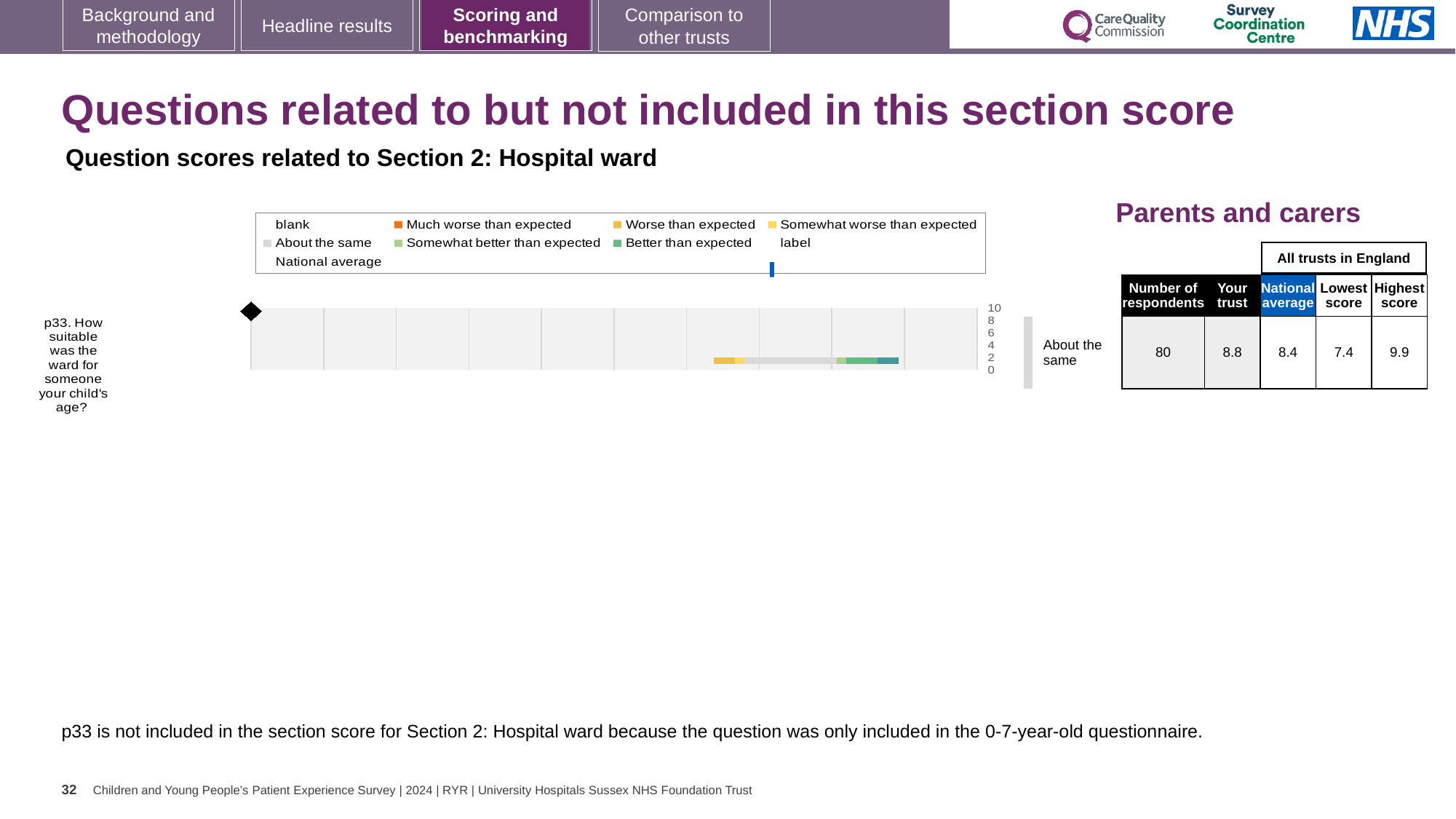
In the Parents and carers table, what is the national average score for p33? 8.4 What benchmarking category label is shown to the right of the bar for p33? About the same For p33, what is the difference between the highest score and the lowest score among all trusts in England? 2.5 In the Parents and carers table, what is the lowest score among all trusts in England for p33? 7.4 For p33, which is larger: the 'Your trust' score or the national average? Your trust In the Parents and carers table, what is the 'Your trust' score for p33? 8.8 What kind of chart is used to show the score for question p33? bar chart In the Parents and carers table, what is the highest score among all trusts in England for p33? 9.9 How many respondents are listed for p33 in the Parents and carers table? 80 For p33, what is the difference between the 'Your trust' score and the national average? 0.4 How many survey questions are plotted in the chart? 1 Which survey question is plotted in the chart? p33. How suitable was the ward for someone your child's age?